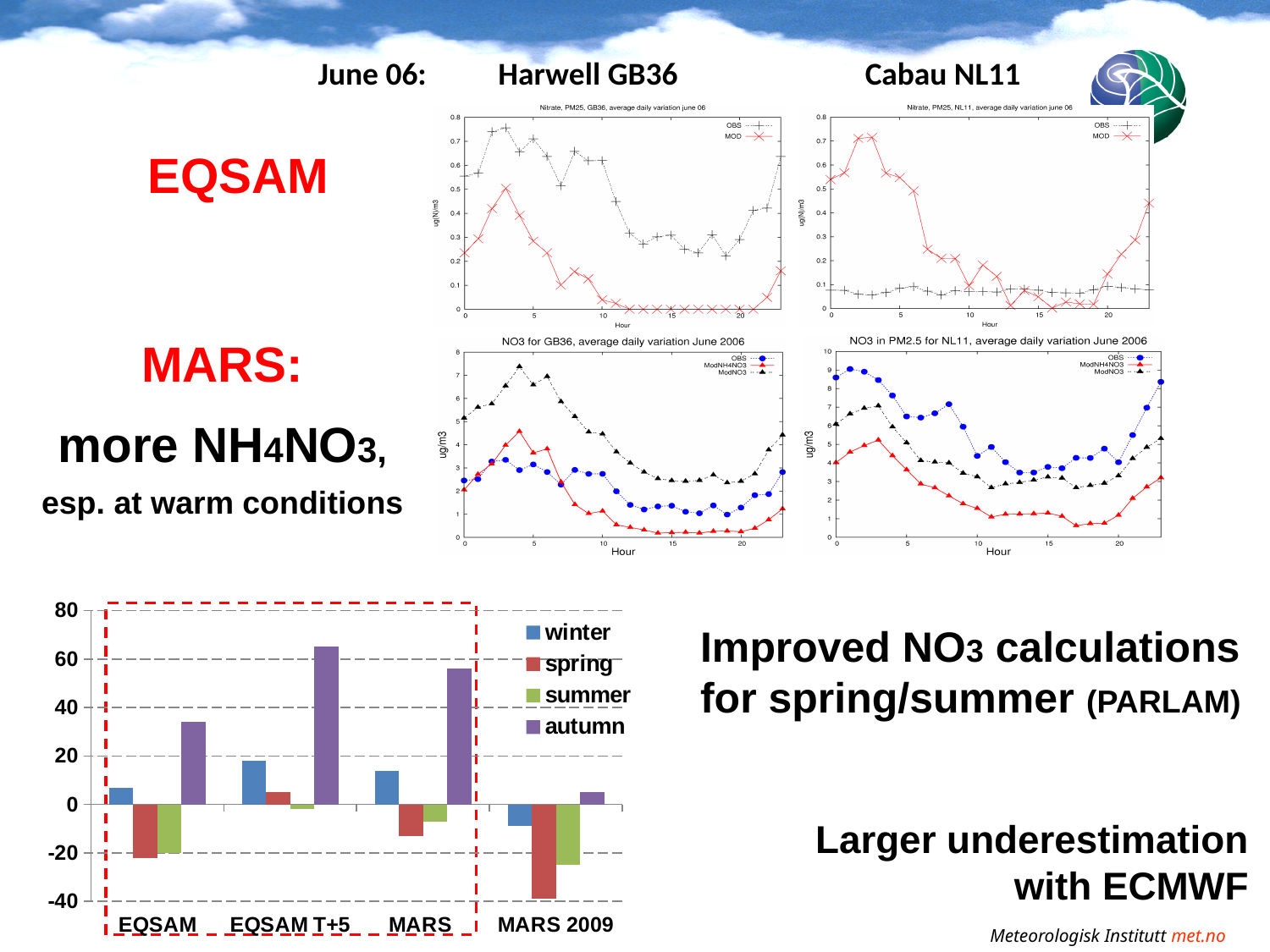
In the bottom-left bar chart, which is larger: the winter value for EQSAM or the winter value for EQSAM T+5? EQSAM T+5 In the bottom-left bar chart, is the spring value for MARS 2009 greater or less than -20? less In the bottom-left bar chart, what are the four legend entries? winter, spring, summer, autumn In the bottom-left bar chart, how many categories are shown on the x axis? 4 In the bottom-left bar chart, is the autumn value for EQSAM T+5 greater or less than 60? greater What kind of chart is the top chart titled 'Nitrate, PM25, GB36, average daily variation june 06'? line chart What kind of chart is the bottom-left chart with the categories EQSAM, EQSAM T+5, MARS and MARS 2009? bar chart In the bottom-left bar chart, which category has the highest autumn value? EQSAM T+5 In the bottom-left bar chart, which category has the lowest spring value? MARS 2009 In the bottom-left bar chart, how many series does the legend list? 4 In the chart titled 'NO3 for GB36, average daily variation June 2006', how many series does the legend list? 3 In the bottom-left bar chart, which is larger: the autumn value for EQSAM or the autumn value for MARS? MARS